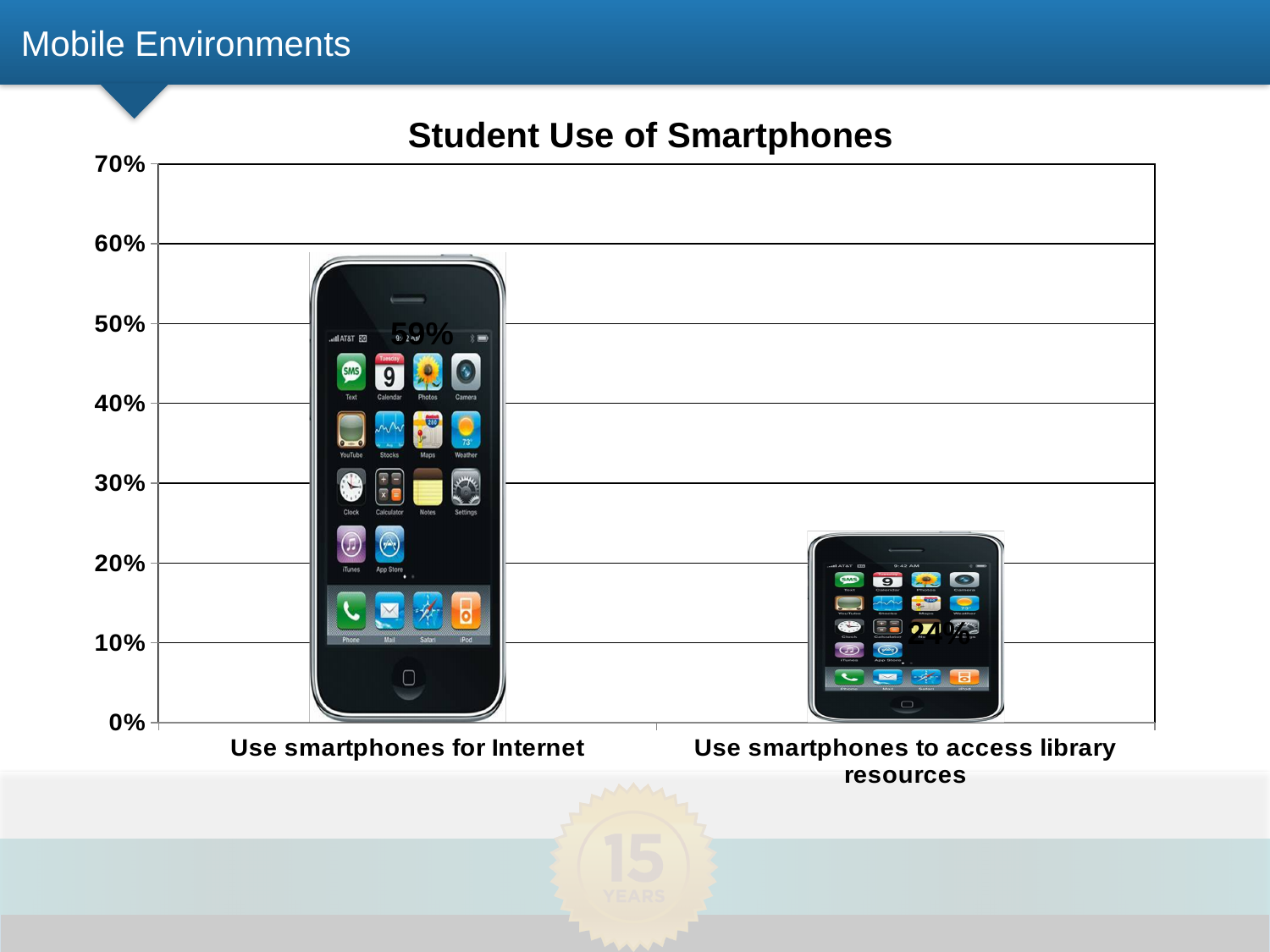
What is the maximum value shown on the vertical axis of the chart? 70% Which category has the lowest value in the Student Use of Smartphones chart? Use smartphones to access library resources What kind of chart is shown on the slide? bar chart Is the value for "Use smartphones to access library resources" greater or less than 30%? less How many categories are shown in the Student Use of Smartphones chart? 2 What is the value for "Use smartphones for Internet" in the Student Use of Smartphones chart? 59% Which category has the highest value in the Student Use of Smartphones chart? Use smartphones for Internet Which is larger: the value for "Use smartphones for Internet" or the value for "Use smartphones to access library resources"? Use smartphones for Internet Is the value for "Use smartphones to access library resources" greater or less than 20%? greater Is the value for "Use smartphones for Internet" greater or less than 50%? greater What is the title of the chart on the slide? Student Use of Smartphones